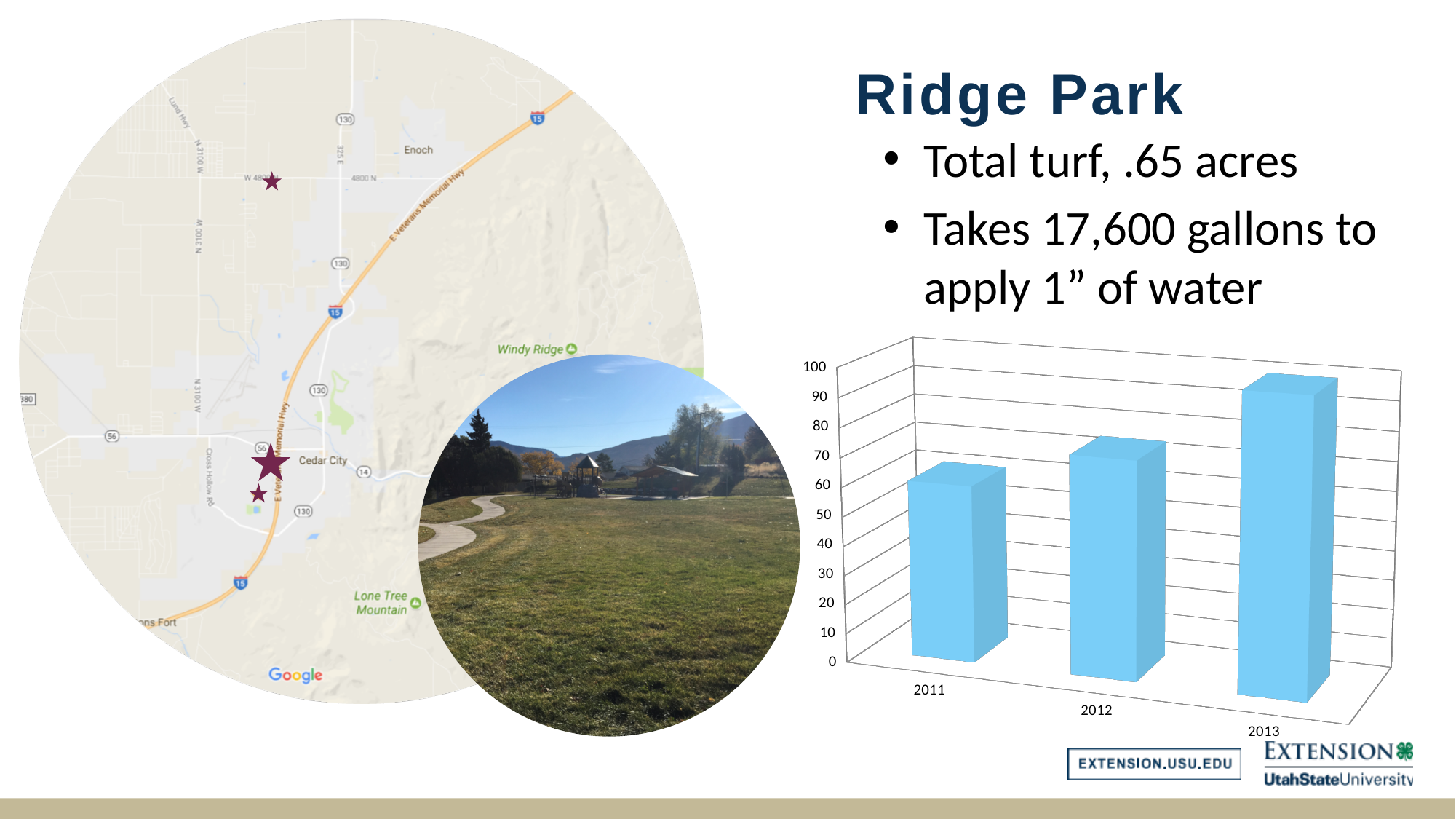
Is the value for 2012 greater or less than 90? less Do the bar values rise or fall from 2011 to 2013? rise Is the value for 2011 greater or less than 40? greater Is the value for 2013 greater or less than 80? greater Which is larger, the value for 2012 or the value for 2011? 2012 What kind of chart is shown on the slide? bar chart Which is larger, the value for 2013 or the value for 2011? 2013 Which year has the lowest bar in the chart? 2011 How many categories (years) are plotted in the chart? 3 What is the highest value shown on the chart's vertical axis? 100 Which year has the highest bar in the chart? 2013